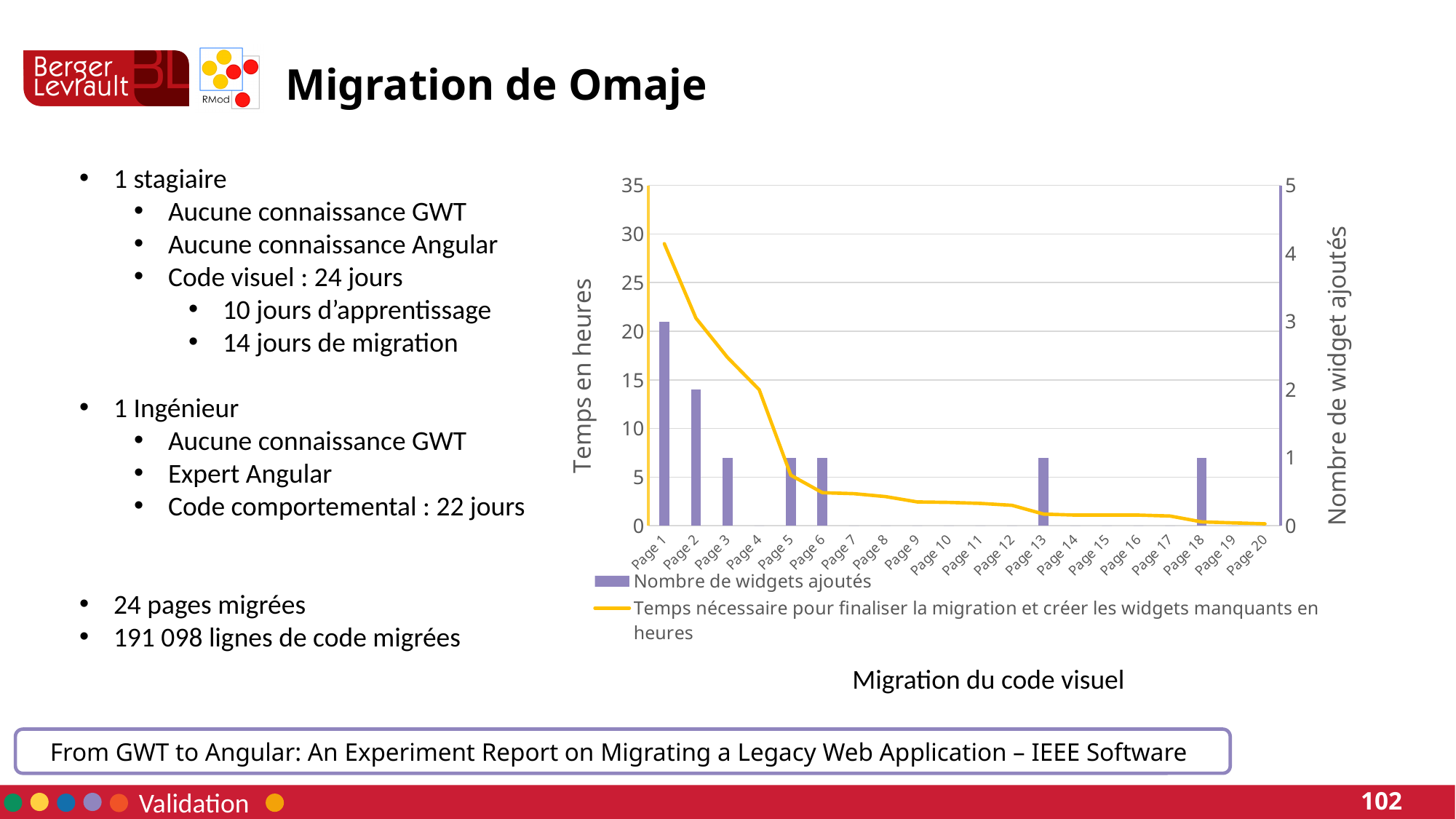
Does the time needed to finalise the migration (line series) rise or fall from Page 1 to Page 20? It falls What is the title of the right vertical axis of the chart? Nombre de widget ajoutés How many widgets were added for Page 2 according to the bar series? 2 What kind of chart is shown on the slide? A combined bar and line chart What is the title of the left vertical axis of the chart? Temps en heures Is the time in hours for Page 1 on the line series greater or less than 25? greater How many widgets were added for Page 1 according to the bar series? 3 How many pages (categories) are shown on the x axis of the chart? 20 How many series does the chart legend list? 2 Which page has the highest number of widgets added? Page 1 What is the difference between the number of widgets added for Page 1 and for Page 2? 1 Which is larger, the number of widgets added for Page 1 or for Page 3? Page 1